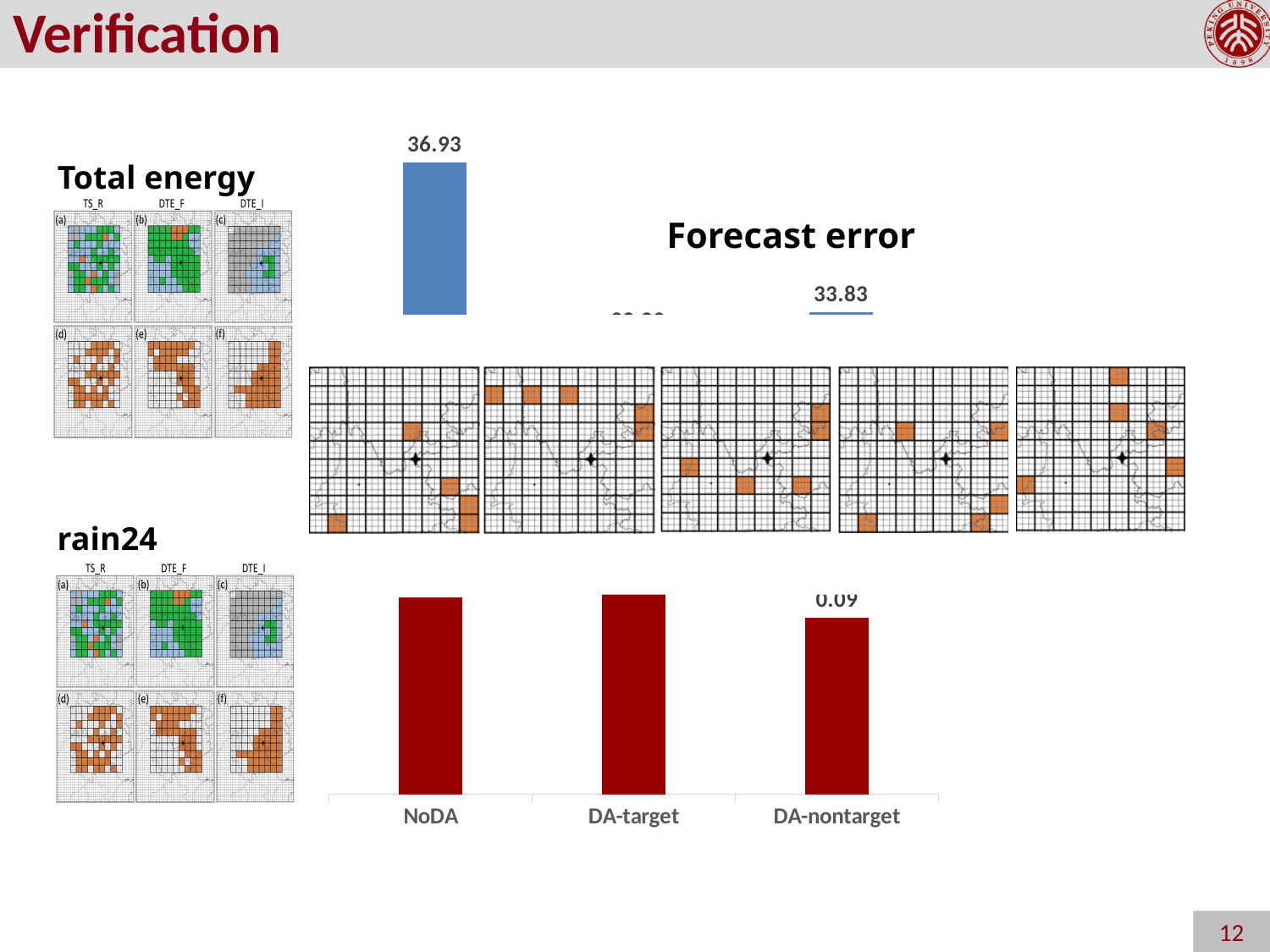
How many categories are shown on the x axis of the lower chart with the dark red bars? 3 In the upper 'Forecast error' chart, what value is labelled on the leftmost blue bar? 36.93 In the upper 'Forecast error' chart, which is larger, the leftmost bar or the rightmost bar? the leftmost bar What are the three category labels on the x axis of the lower chart, from left to right? NoDA, DA-target, DA-nontarget In the upper 'Forecast error' chart, is the value of the leftmost bar greater or less than 35? greater In the upper 'Forecast error' chart, what value is labelled on the rightmost blue bar? 33.83 What is the title of the upper chart with the blue bars? Forecast error In the lower chart with the dark red bars, which is larger, the bar for NoDA or the bar for DA-nontarget? NoDA In the lower chart with the dark red bars, which category has the lowest bar? DA-nontarget In the upper 'Forecast error' chart, what is the difference between the leftmost bar (36.93) and the rightmost bar (33.83)? 3.10 What kind of chart is the lower chart with the dark red bars? bar chart